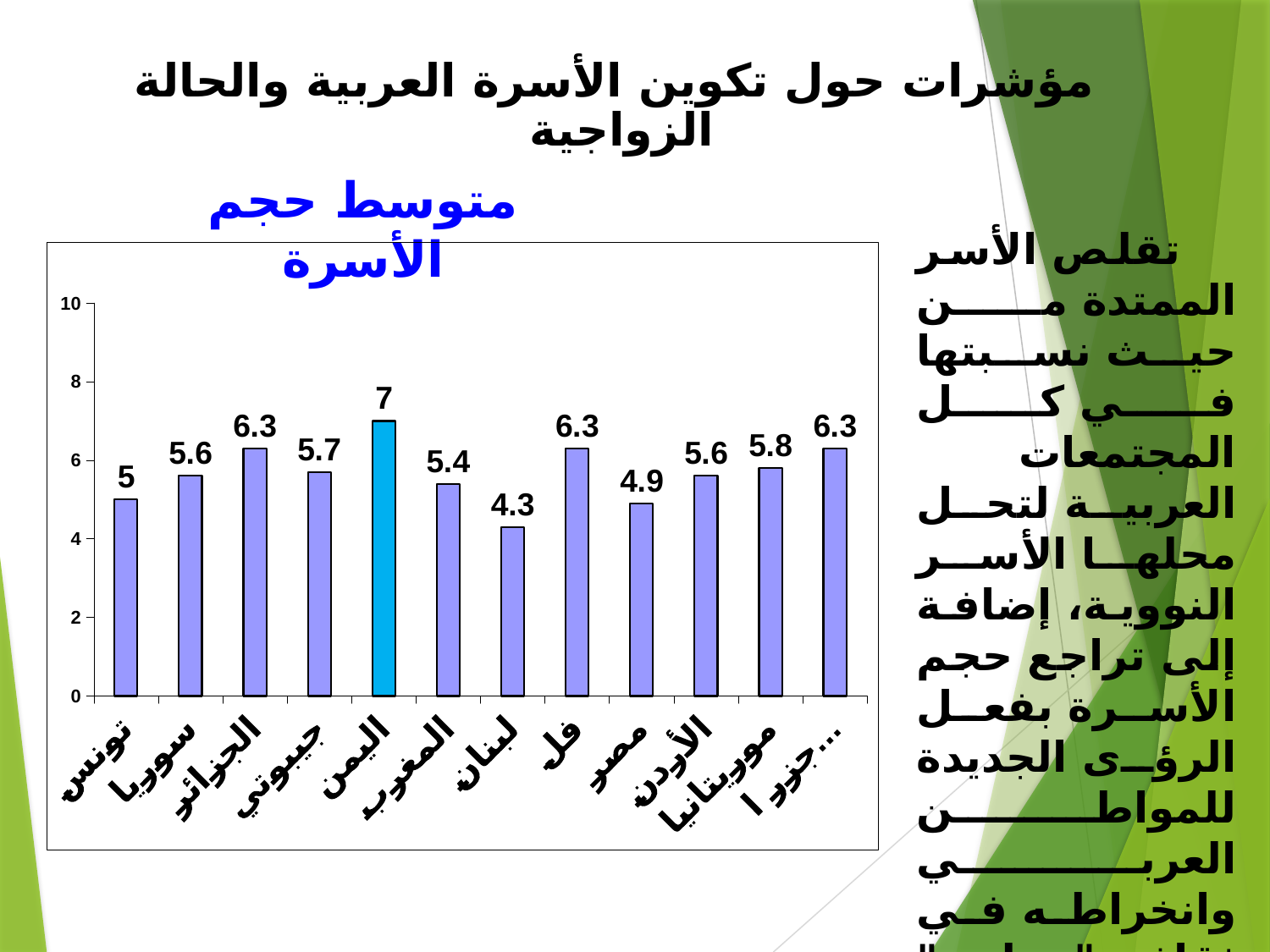
How many countries are shown in the chart? 12 What is the title of the chart? متوسط حجم الأسرة Which country has the lowest average family size? لبنان Is the value for تونس greater or less than 6? less What is the difference between the values for اليمن and لبنان? 2.7 What is the value shown for مصر? 4.9 Which has a larger value, الجزائر or المغرب? الجزائر Which country has the highest average family size? اليمن What is the value shown for لبنان? 4.3 What is the average family size shown for اليمن? 7 What kind of chart is shown on the slide? bar chart What is the value shown for موريتانيا? 5.8